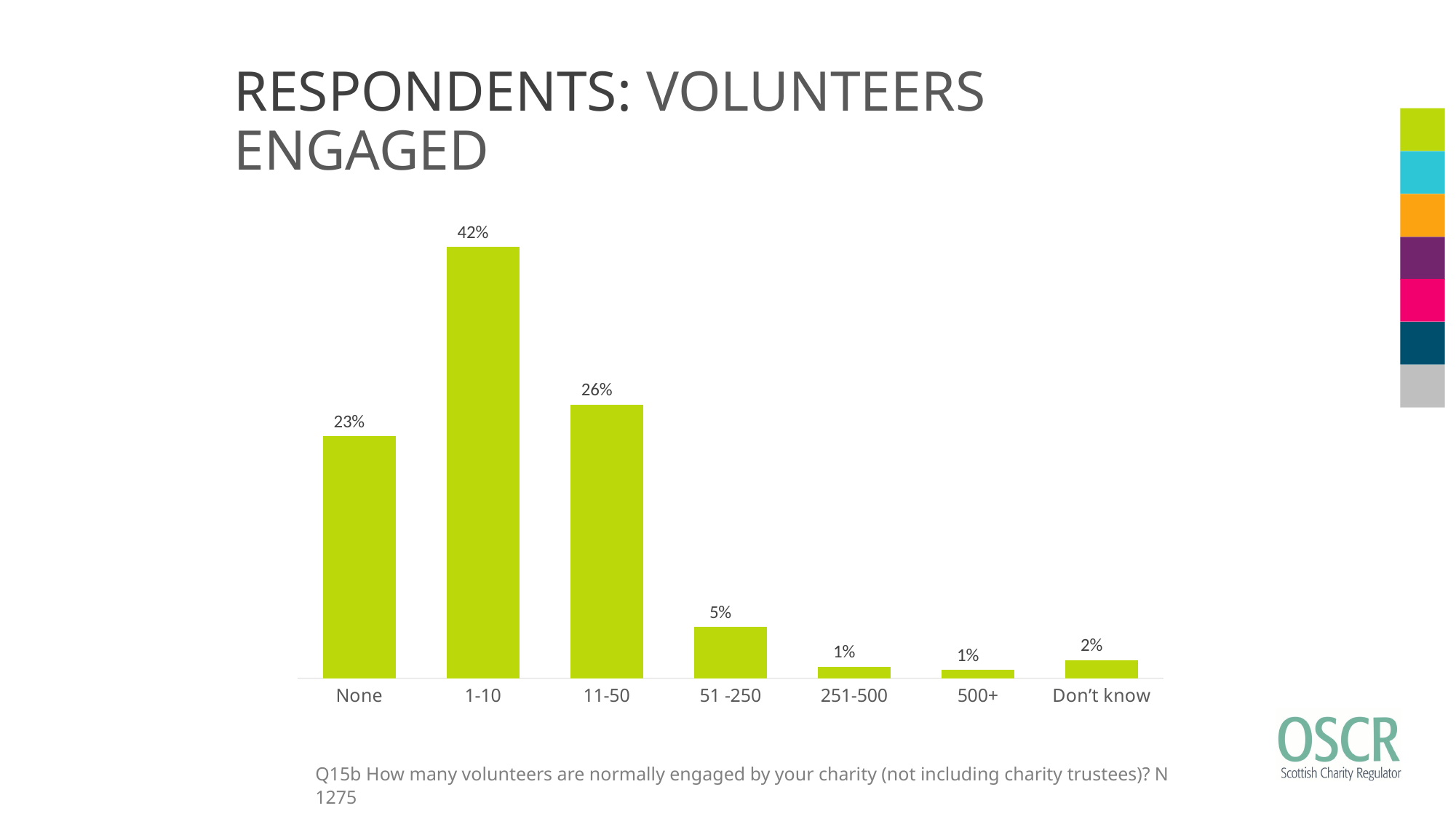
How many categories are shown on the x axis? 7 What is the title of the slide containing the chart? RESPONDENTS: VOLUNTEERS ENGAGED What kind of chart is shown on the slide? Bar chart Which category has the highest value? 1-10 Which is larger, the value for None or the value for 11-50? 11-50 What is the difference between the 1-10 and 11-50 values? 16% What percentage of respondents reported engaging 1-10 volunteers? 42% What is the value for the 51 -250 category? 5% What is the value for the Don't know category? 2% Which is larger, the value for 51 -250 or the value for Don't know? 51 -250 What percentage of respondents reported engaging no volunteers (None)? 23% What is the difference between the None and 51 -250 values? 18%